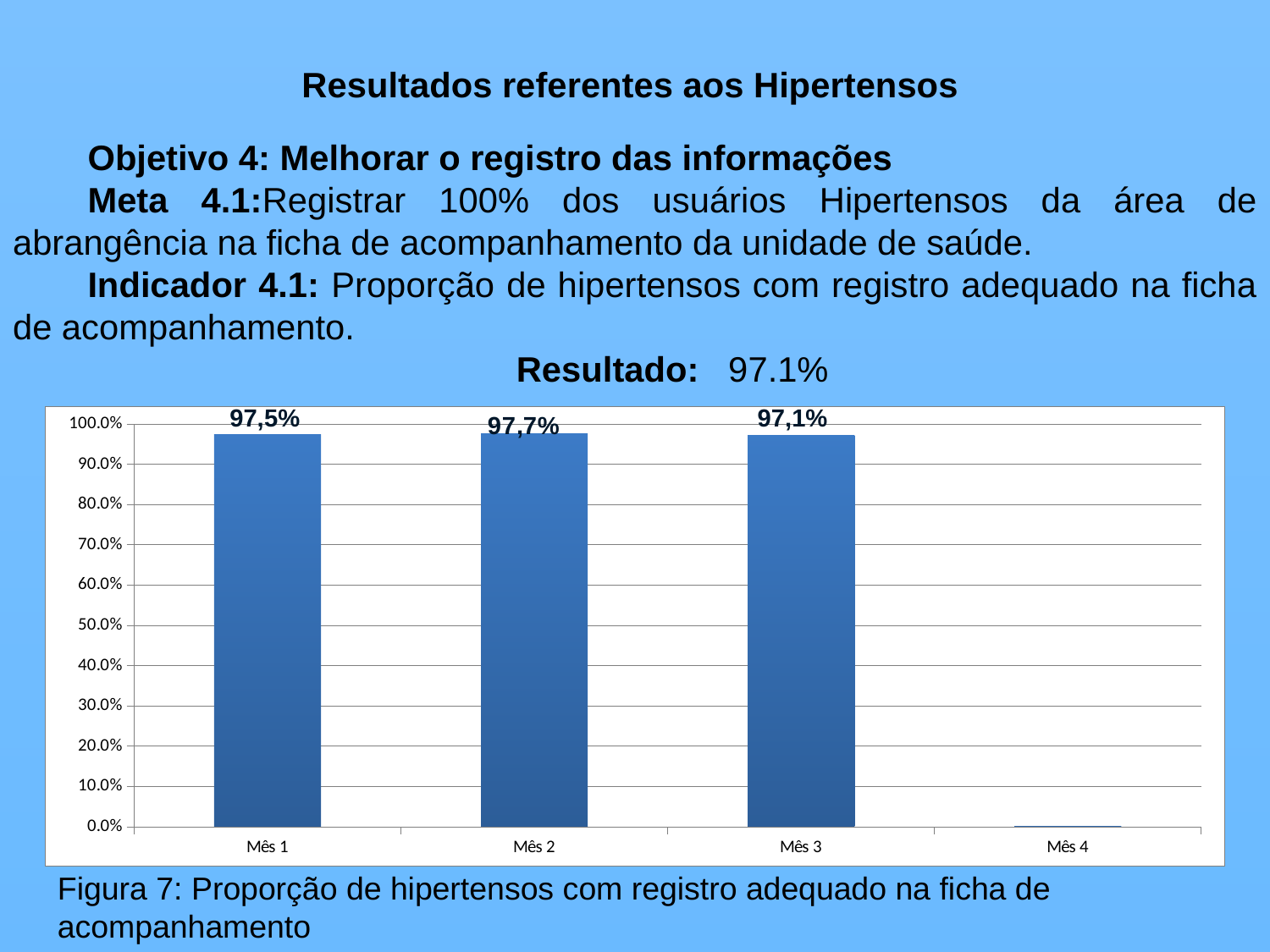
How many months are shown on the x axis? 4 What is the difference between the values for Mês 2 and Mês 3? 0,6% What is the figure caption below the chart? Figura 7: Proporção de hipertensos com registro adequado na ficha de acompanhamento Which is larger, the value for Mês 1 or the value for Mês 3? Mês 1 What is the value shown for Mês 2? 97,7% What is the value shown for Mês 1? 97,5% What is the value shown for Mês 3? 97,1% Which month has the lowest bar? Mês 4 Which month has the highest labelled value? Mês 2 Is the value for Mês 4 greater or less than 10.0%? less What is the difference between the values for Mês 1 and Mês 3? 0,4% What kind of chart is shown on the slide? bar chart